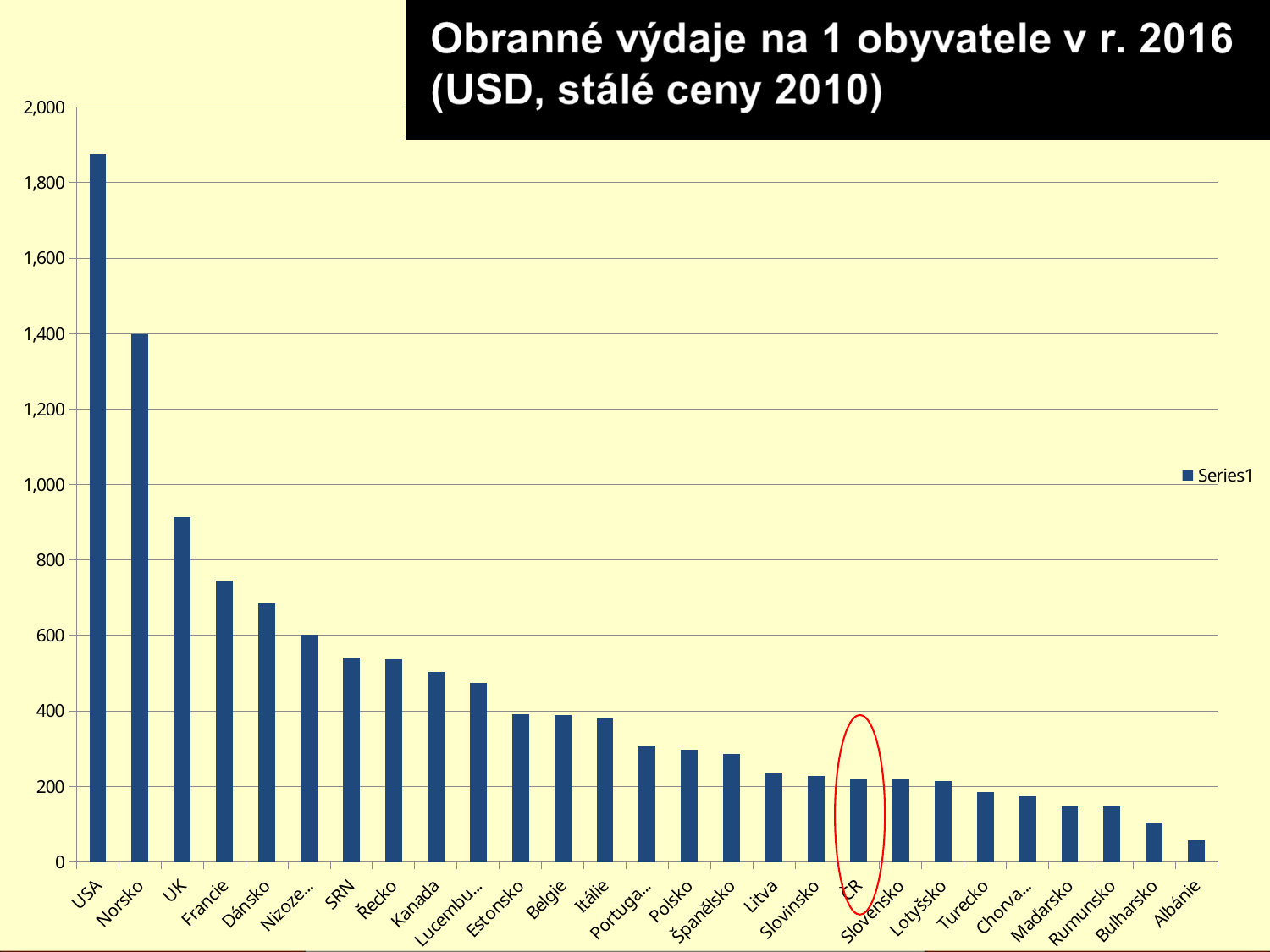
Is the value for Francie greater or less than 800? less Is the value for USA greater or less than 1,800? greater Which has a larger value, Litva or Bulharsko? Litva Do the values rise or fall moving from left to right along the x axis? fall Which country has the lowest value in the chart? Albánie How many series does the legend list? 1 Is the value for Polsko greater or less than 400? less Which country has the highest defence spending per inhabitant in the chart? USA What kind of chart is shown on the slide? bar chart Which has a larger value, Francie or Dánsko? Francie